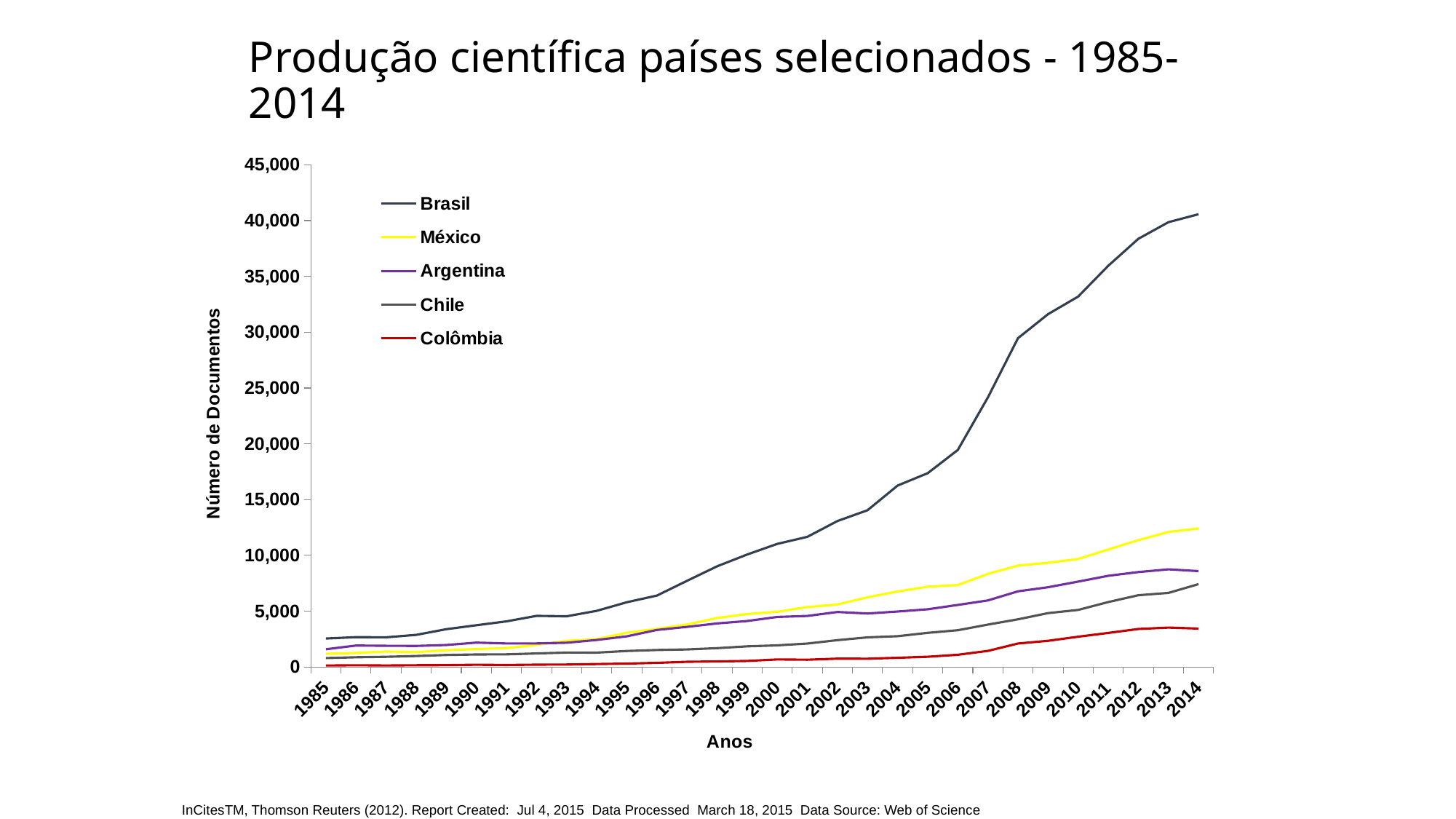
In 2014, which is larger, the value for México or the value for Argentina? México Is the value for Brasil in 2014 greater or less than 40,000? greater What kind of chart is shown on the slide? line chart How many years are plotted along the x axis? 30 How many series does the legend list? 5 Is the value for México in 2014 greater or less than 10,000? greater Does the Brasil line rise or fall from 1985 to 2014? rise Is the value for Colômbia in 2014 greater or less than 5,000? less Which country has the highest number of documents in 2014? Brasil What is the label of the y axis? Número de Documentos Which country has the lowest number of documents in 2014? Colômbia